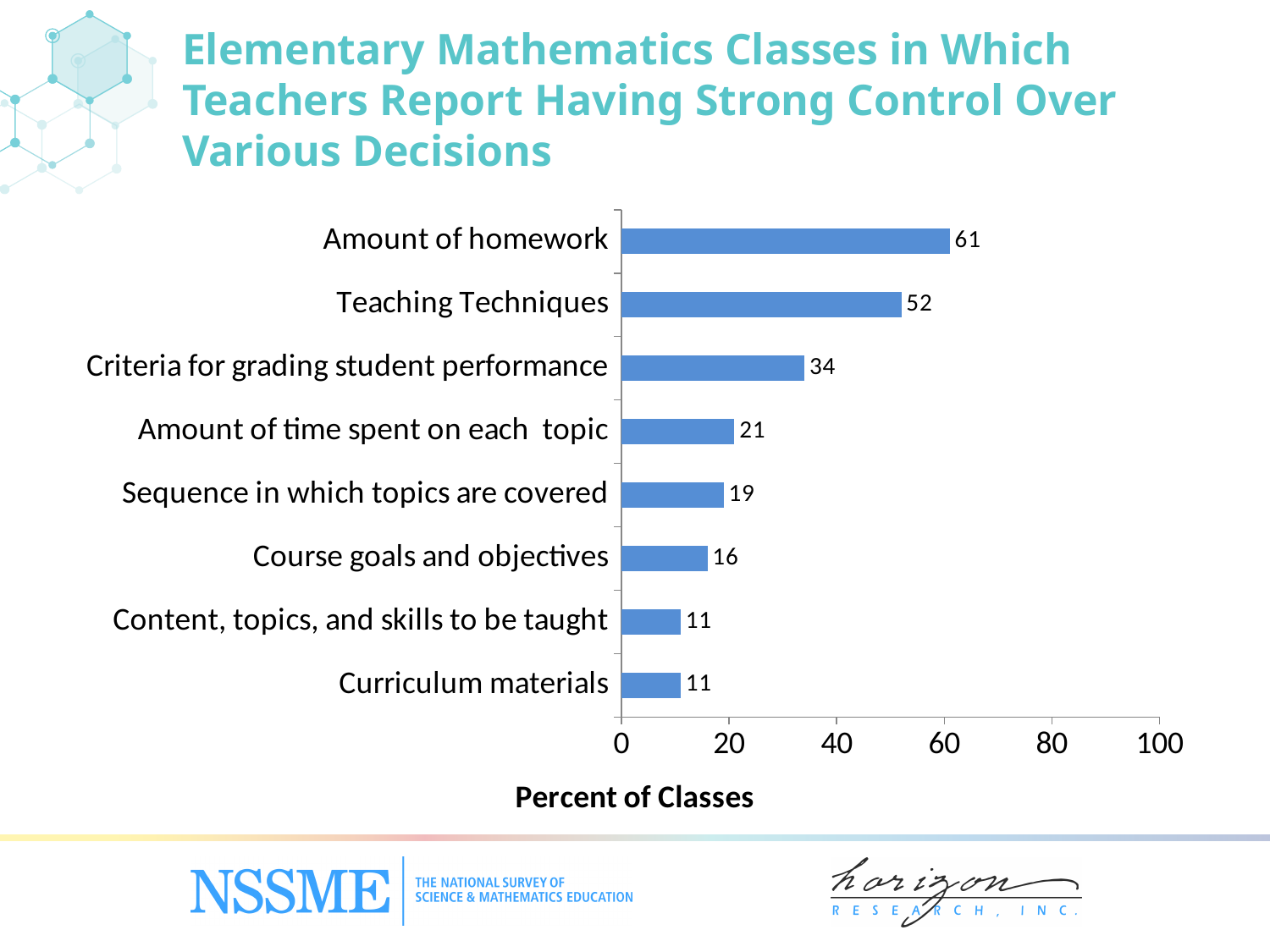
What is the value for Criteria for grading student performance? 34 Which category has the highest value? Amount of homework What is the lowest value shown on the chart? 11 What is the difference between the values for Amount of homework and Teaching Techniques? 9 What is the difference between the values for Amount of time spent on each topic and Course goals and objectives? 5 What kind of chart is shown on the slide? bar chart What is the value for Sequence in which topics are covered? 19 How many categories are shown on the chart? 8 Is the value for Amount of homework greater or less than 60? greater Which is larger, the value for Teaching Techniques or the value for Criteria for grading student performance? Teaching Techniques What percent of classes is shown for Amount of homework? 61 What is the label of the horizontal axis? Percent of Classes